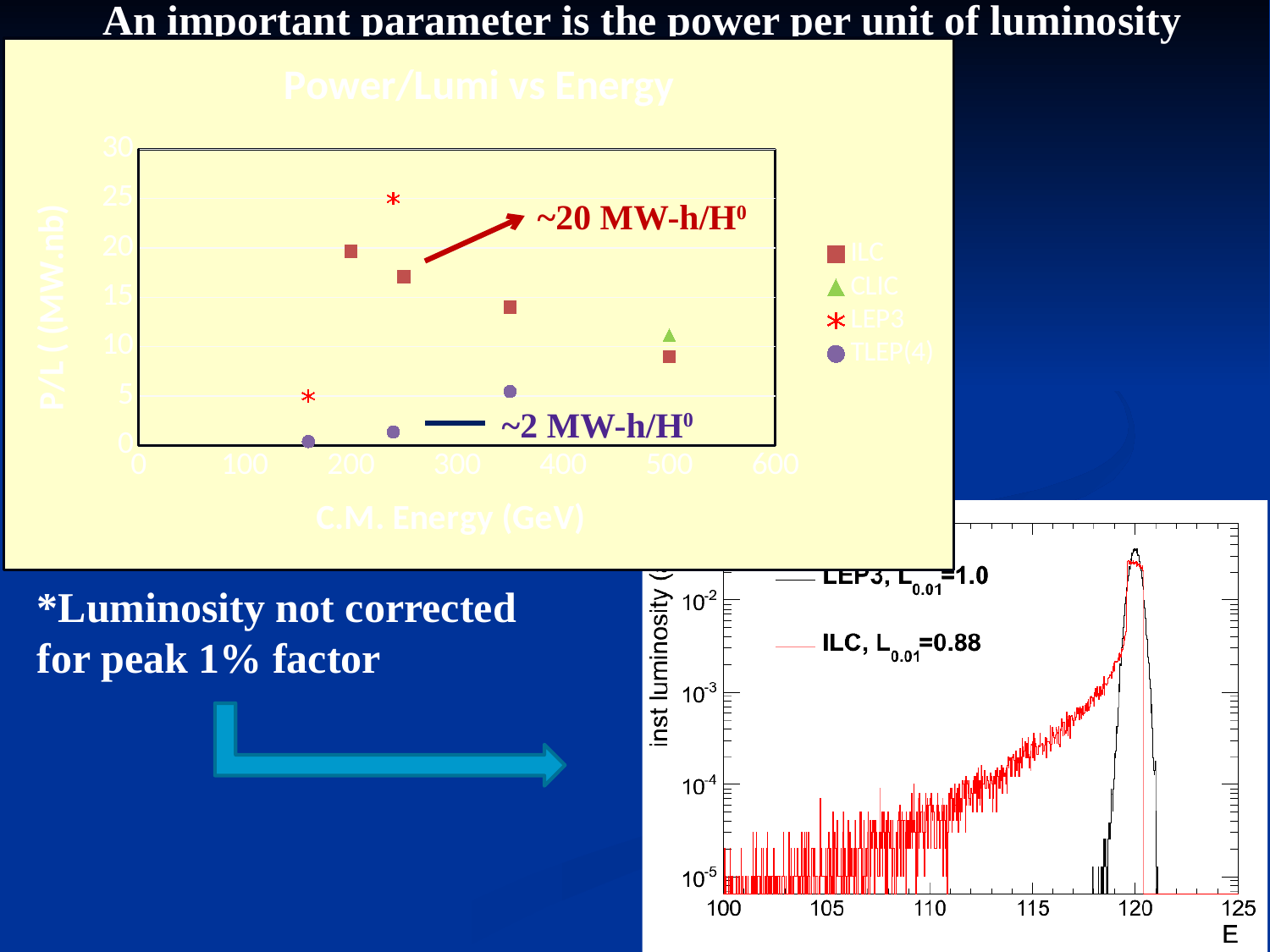
In the Power/Lumi vs Energy chart, at 500 GeV, which is larger: the CLIC value or the ILC value? CLIC In the Power/Lumi vs Energy chart, how many ILC points are plotted? 4 In the Power/Lumi vs Energy chart, is the TLEP(4) value at 350 GeV greater or less than 10? less In the Power/Lumi vs Energy chart, is the LEP3 value near 240 GeV greater or less than 20? greater In the Power/Lumi vs Energy chart, which series has the highest plotted point? LEP3 In the Power/Lumi vs Energy chart, which series has the lowest plotted point? TLEP(4) In the Power/Lumi vs Energy chart, how many series does the legend list? 4 In the inst luminosity vs E chart at the bottom right, how many series does the legend list? 2 In the Power/Lumi vs Energy chart, what is the label of the x axis? C.M. Energy (GeV) What kind of chart is the Power/Lumi vs Energy chart? scatter chart In the inst luminosity vs E chart at the bottom right, what L0.01 value is given for ILC in the legend? 0.88 In the Power/Lumi vs Energy chart, is the ILC value at 200 GeV greater or less than 15? greater